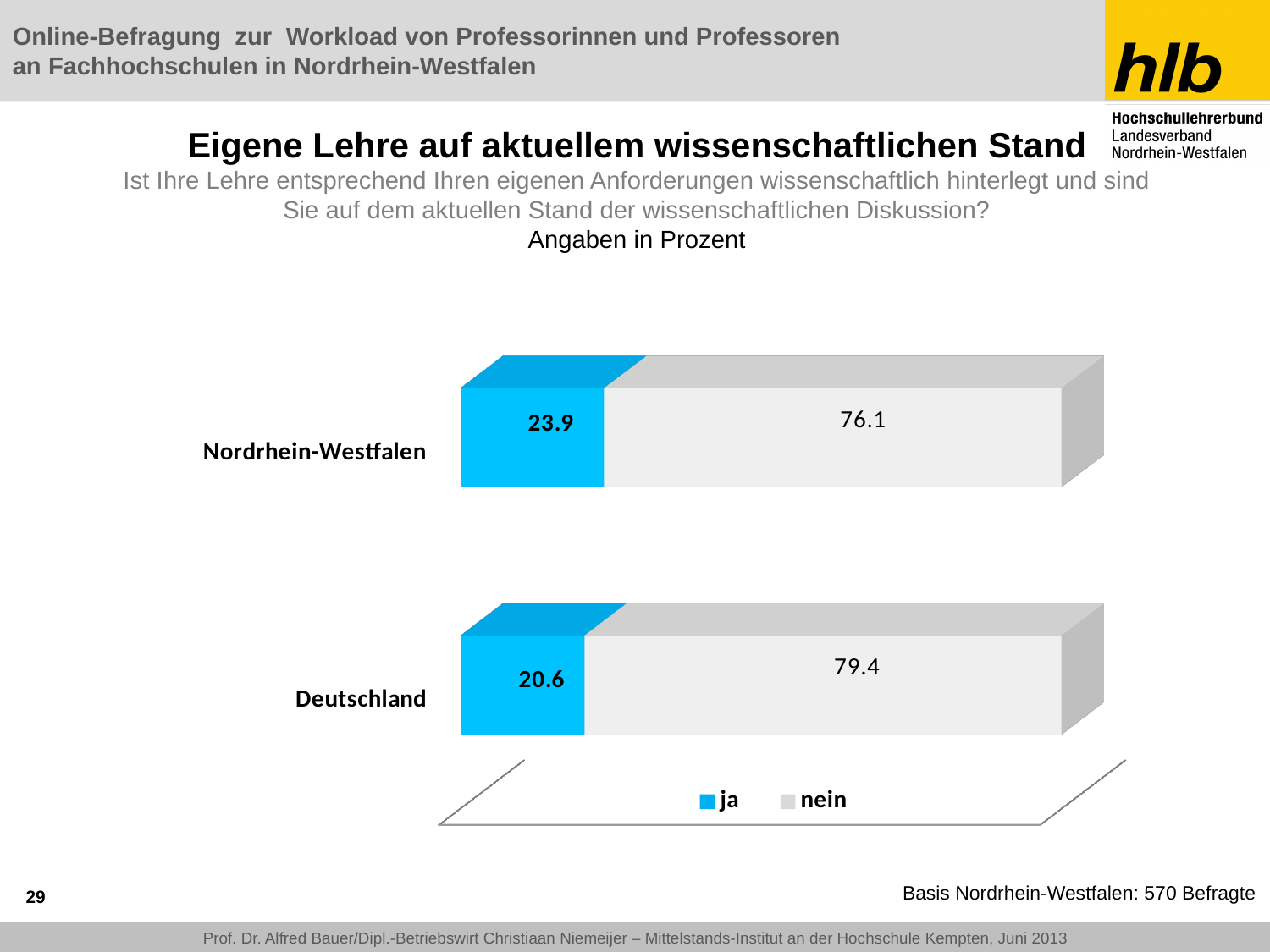
What is the 'ja' value for Deutschland? 20.6 What is the 'ja' value for Nordrhein-Westfalen? 23.9 Which category has the higher 'ja' value, Nordrhein-Westfalen or Deutschland? Nordrhein-Westfalen What is the difference between the 'ja' values for Nordrhein-Westfalen and Deutschland? 3.3 Which colour represents the 'ja' series in the chart? Blue What is the 'nein' value for Nordrhein-Westfalen? 76.1 What is the 'nein' value for Deutschland? 79.4 What kind of chart is shown on the slide? Stacked bar chart How many series does the legend list? 2 What is the total of the stacked bar for Nordrhein-Westfalen? 100 How many categories are shown in the chart? 2 Which category has the highest 'nein' value? Deutschland